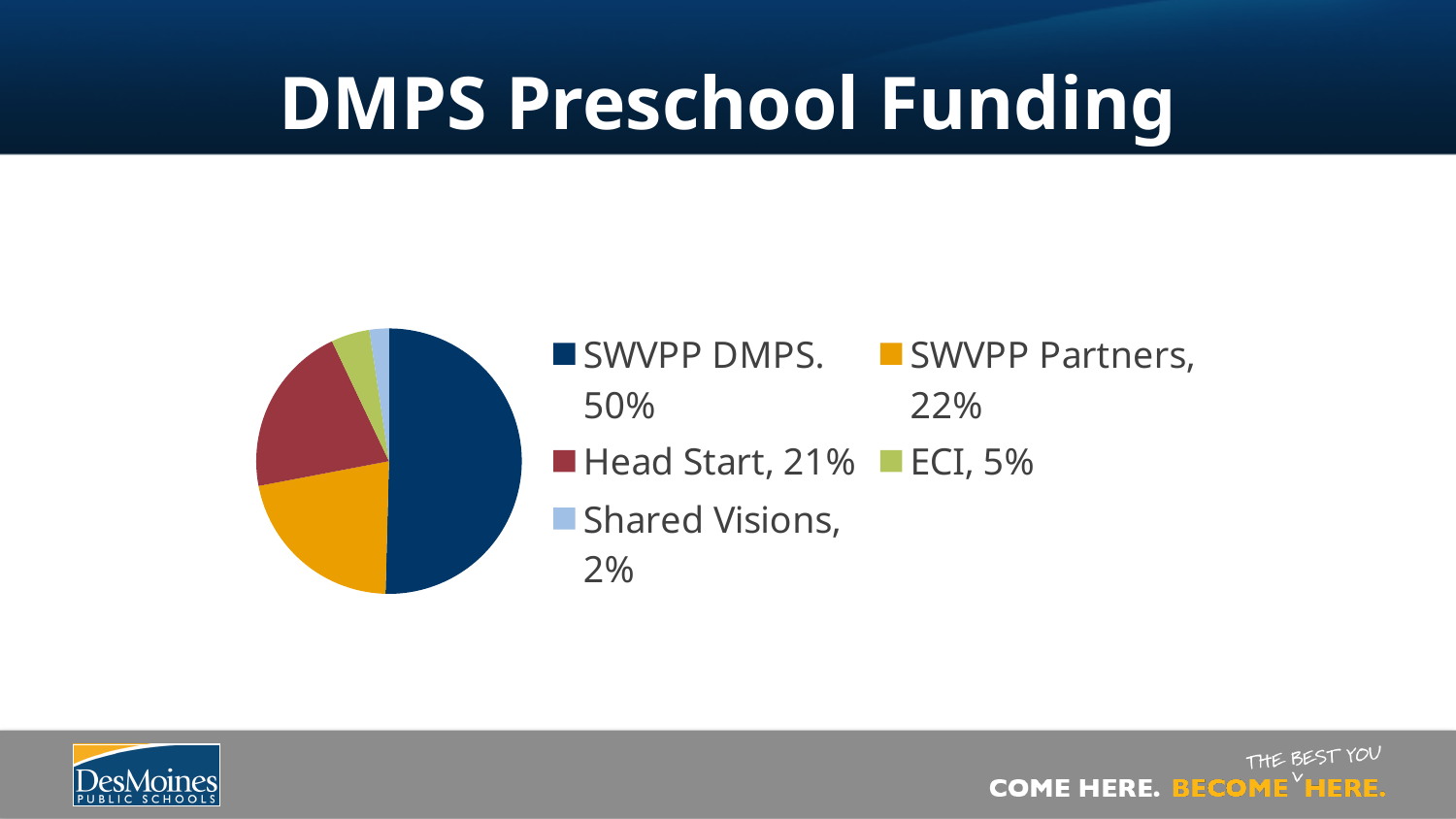
Which funding source has the largest share of the pie? SWVPP DMPS What share of funding comes from Shared Visions? 2% Which funding source has the smallest share of the pie? Shared Visions How many funding sources are shown in the pie chart? 5 What share of funding comes from SWVPP Partners? 22% What is the title of the slide containing the pie chart? DMPS Preschool Funding What kind of chart is shown on the slide? pie chart What share of funding comes from ECI? 5% What share of funding comes from Head Start? 21% What share of DMPS preschool funding comes from SWVPP DMPS? 50% Which is larger, the share for ECI or the share for Shared Visions? ECI What is the difference in percentage points between SWVPP DMPS and Head Start? 29